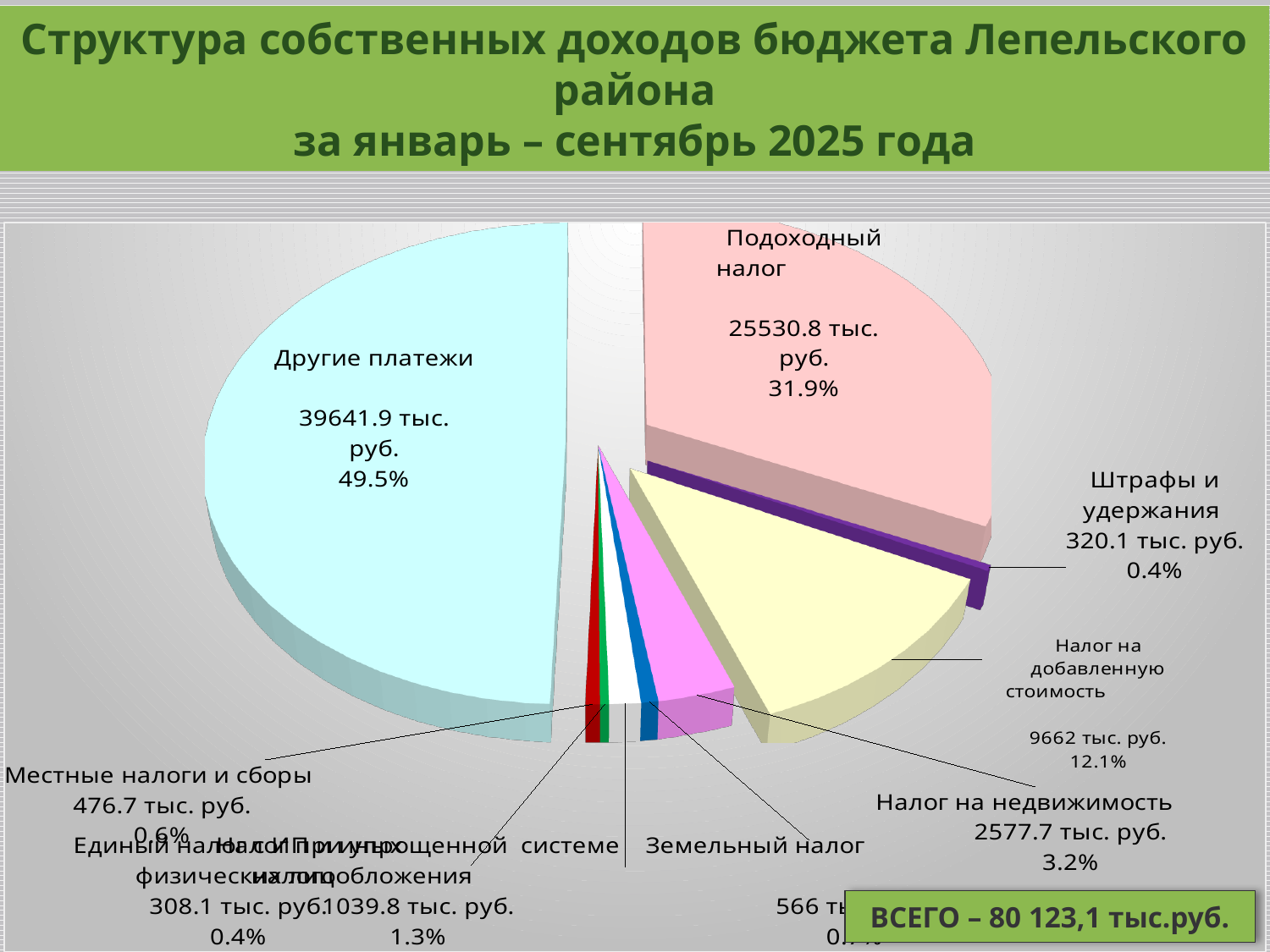
Which is larger, Налог на недвижимость or Штрафы и удержания? Налог на недвижимость What share of the pie does Подоходный налог represent? 31.9% What share of the pie does Другие платежи represent? 49.5% What is the value shown for Другие платежи? 39641.9 тыс. руб. What is the difference between the values for Другие платежи and Подоходный налог? 14111.1 тыс. руб. What kind of chart is shown on the slide? pie chart How many slices does the pie chart have? 9 What is the value shown for Налог на добавленную стоимость? 9662 тыс. руб. What is the value shown for Штрафы и удержания? 320.1 тыс. руб. What total (ВСЕГО) is stated on the slide? 80 123,1 тыс.руб. What share of the pie does Налог на недвижимость represent? 3.2% Which category has the largest slice of the pie? Другие платежи